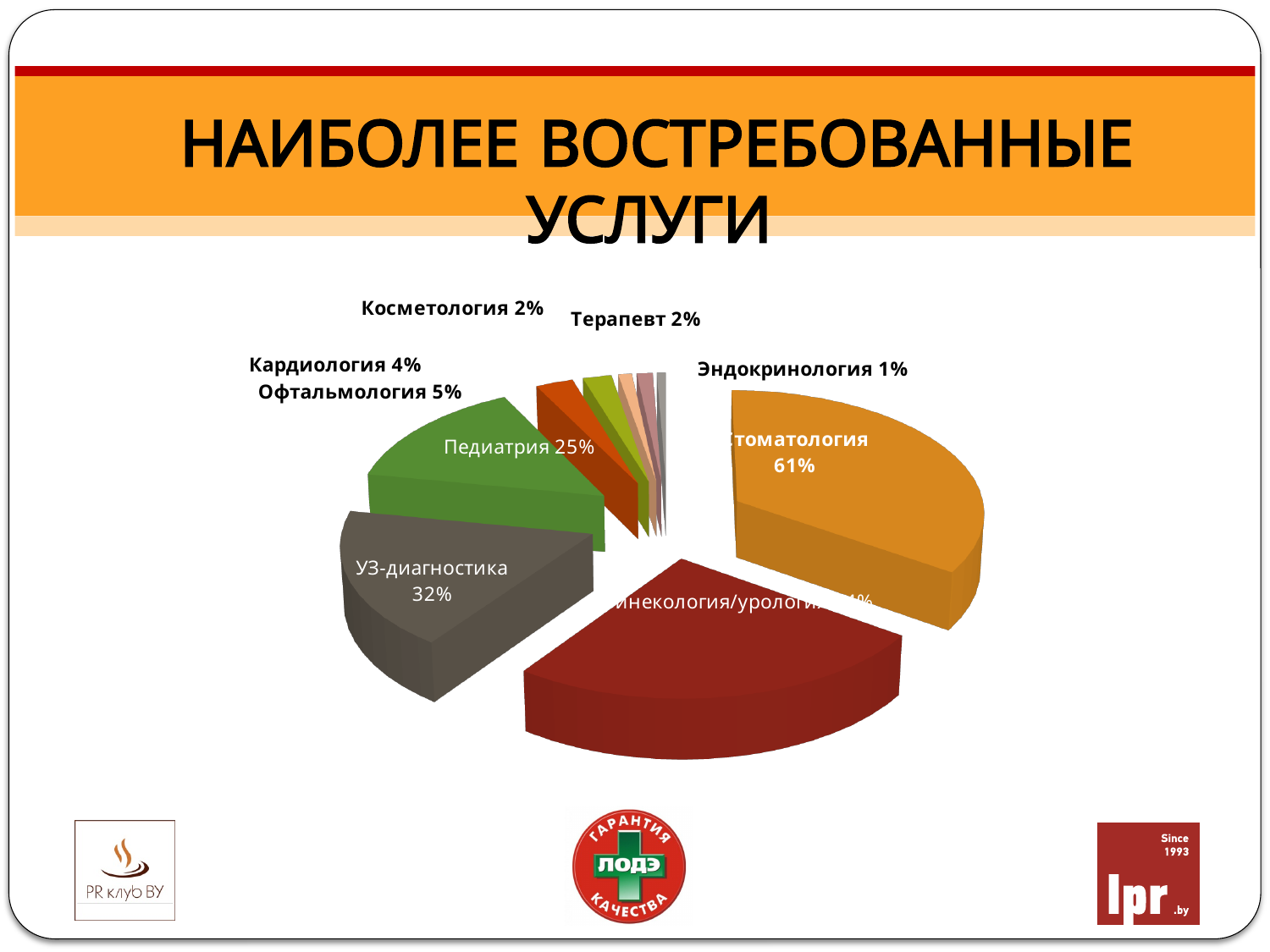
What is the value shown for Педиатрия? 25% What is the difference between the values for Стоматология and УЗ-диагностика? 29% Which category has the lowest value in the chart? Эндокринология What is the value shown for Эндокринология? 1% Which is larger, the value for Педиатрия or the value for УЗ-диагностика? УЗ-диагностика What is the value shown for Кардиология? 4% What is the value shown for Стоматология? 61% What is the value shown for Офтальмология? 5% What is the value shown for УЗ-диагностика? 32% Which category has the highest value in the chart? Стоматология What kind of chart is shown on the slide? pie chart What is the title of the slide containing the chart? НАИБОЛЕЕ ВОСТРЕБОВАННЫЕ УСЛУГИ